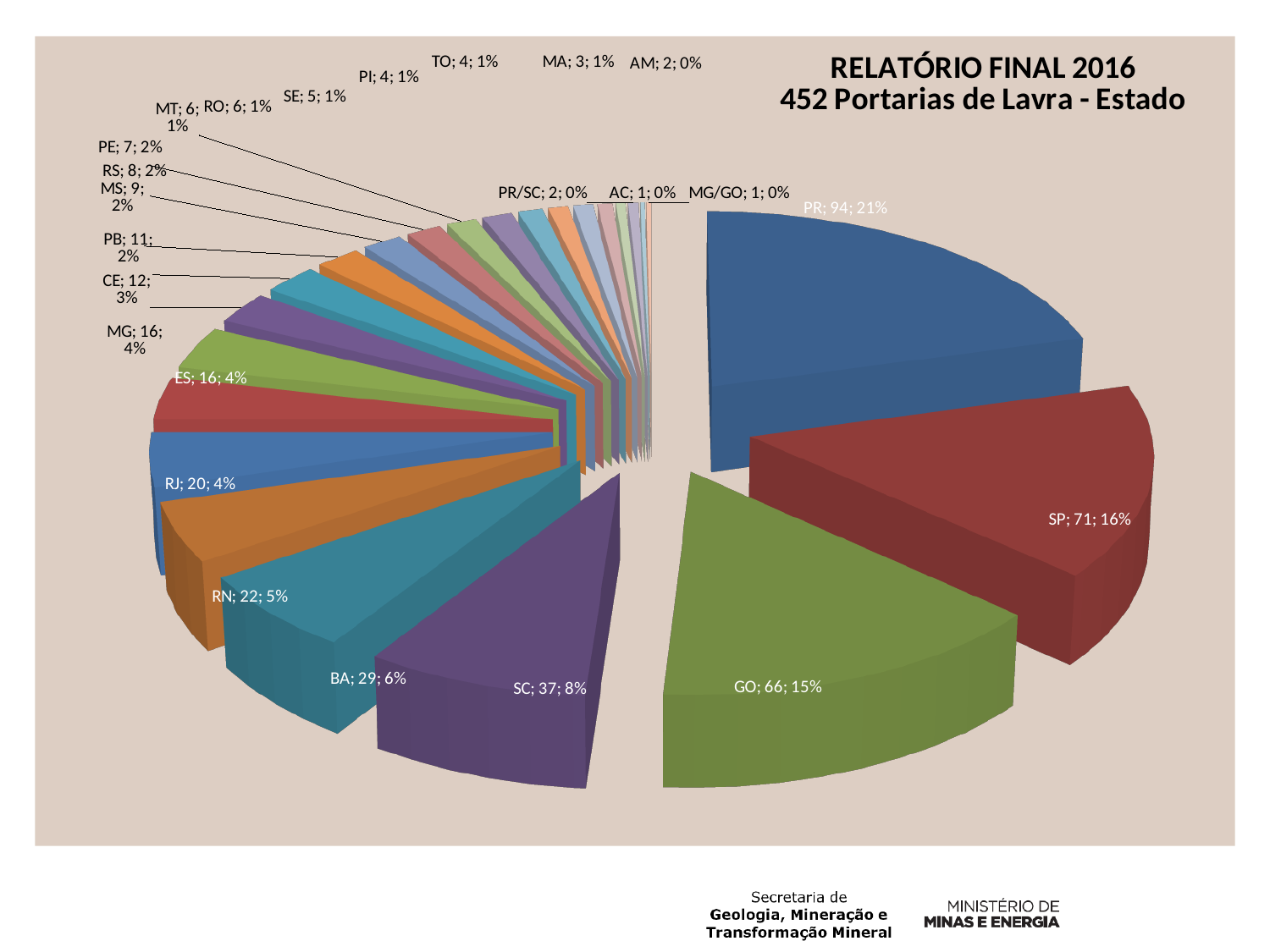
What is the difference between the values for PR and SP? 23 What is the value shown for RN? 22 What is the difference between the values for GO and SC? 29 What percentage share does MG have in the pie chart? 4% What is the title of the chart? RELATÓRIO FINAL 2016 452 Portarias de Lavra - Estado What is the value shown for GO? 66 What kind of chart is shown on the slide? pie chart Which is larger, the value for SC or the value for BA? SC What percentage share does SP have in the pie chart? 16% What percentage share does SC have? 8% Which state has the largest slice of the pie? PR How many Portarias de Lavra are shown for PR? 94